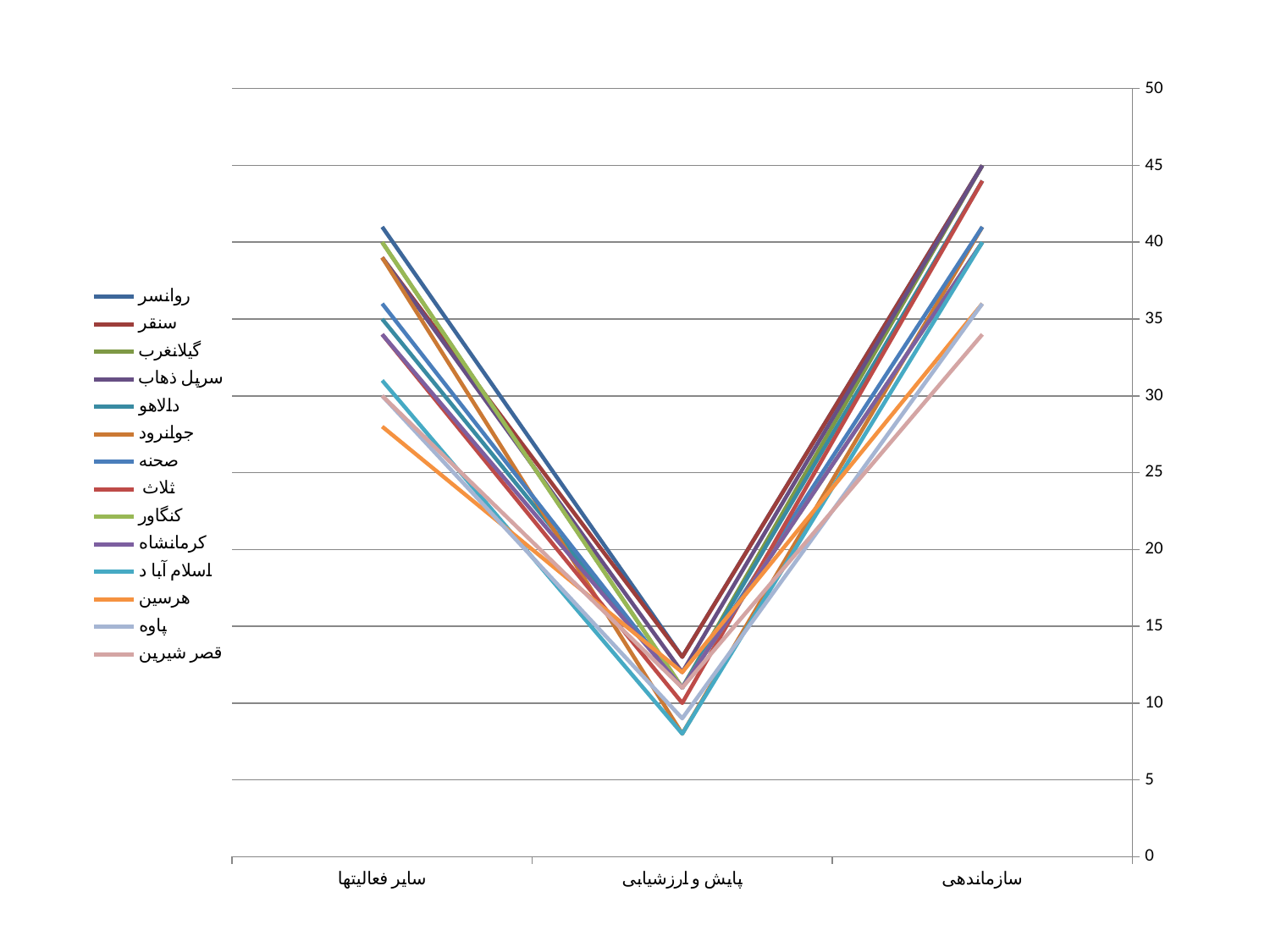
Is the highest value at پایش و ارزشیابی greater or less than 15? less What is the maximum value shown on the vertical axis? 50 Is the highest value at سازماندهی greater or less than 40? greater What kind of chart is shown on the slide? line chart Do the values rise or fall from سایر فعالیتها to پایش و ارزشیابی? fall How many categories are shown on the x axis? 3 How many series does the legend list? 14 Which series is listed first in the legend? روانسر Is the lowest value at پایش و ارزشیابی greater or less than 10? less Which category has the lowest values for all series? پایش و ارزشیابی Do the values rise or fall from پایش و ارزشیابی to سازماندهی? rise